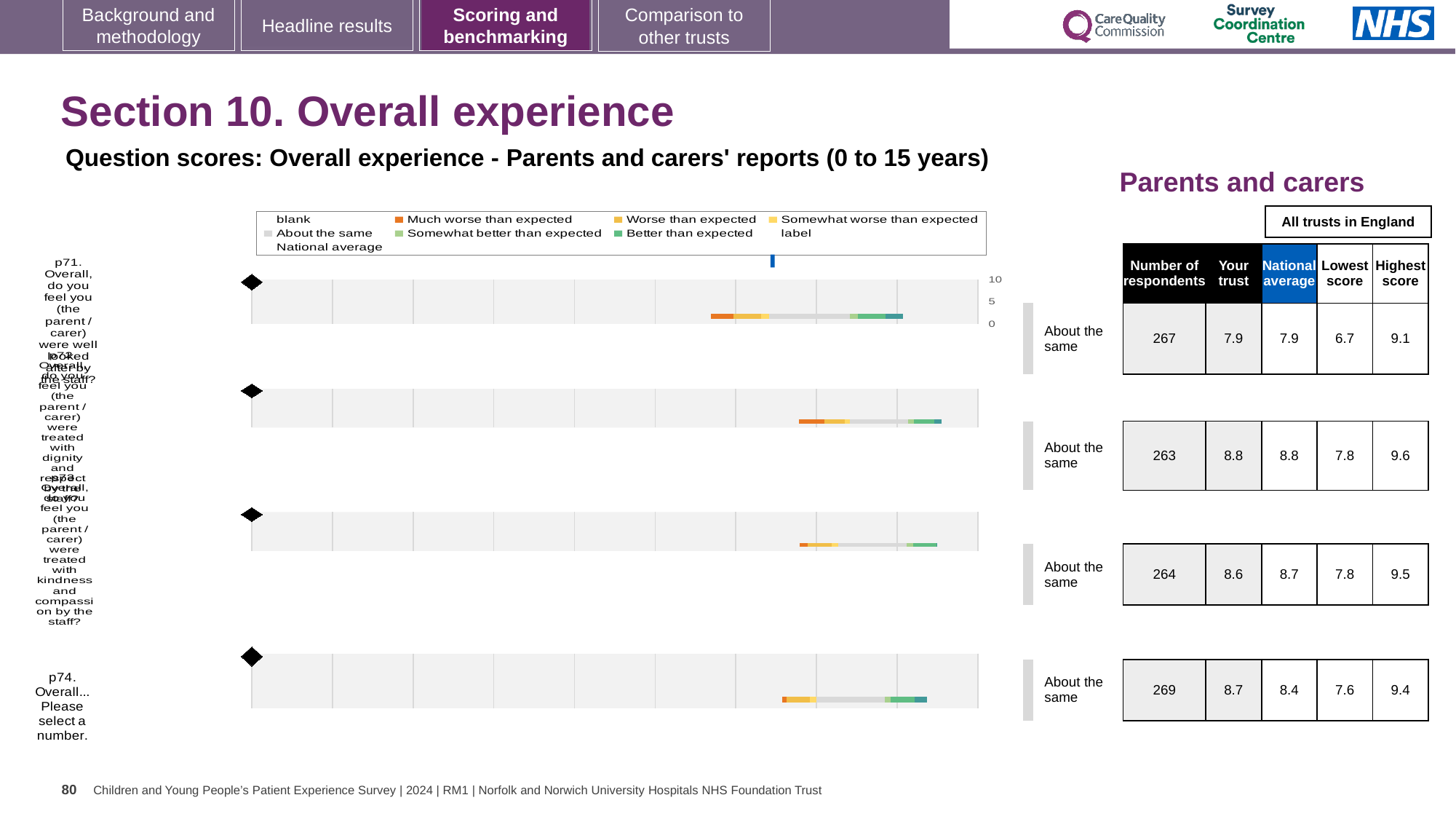
For the last row (p74), which is larger: the 'Your trust' score or the 'National average'? Your trust How many question rows (bars) are plotted in the Overall experience chart? 4 What kind of chart is used to show the question scores for Overall experience? Bar chart What is the subtitle printed above the Overall experience chart? Question scores: Overall experience - Parents and carers' reports (0 to 15 years) In the table beside the chart, what is the highest score for the second row (p72, treated with dignity and respect)? 9.6 In the legend of the Overall experience chart, what colour represents 'Much worse than expected'? Orange In the table beside the chart, what is the 'Your trust' score for the first row (p71, well looked after by the staff)? 7.9 What benchmark label is shown next to the first row (p71) of the chart? About the same Which row in the table has the highest 'Your trust' score? Second row (p72), 8.8 How many entries does the legend of the Overall experience chart list? 9 In the table beside the chart, how many respondents are listed for the last row (p74, Overall... Please select a number)? 269 For the last row (p74), what is the difference between the highest score and the lowest score in the table? 1.8